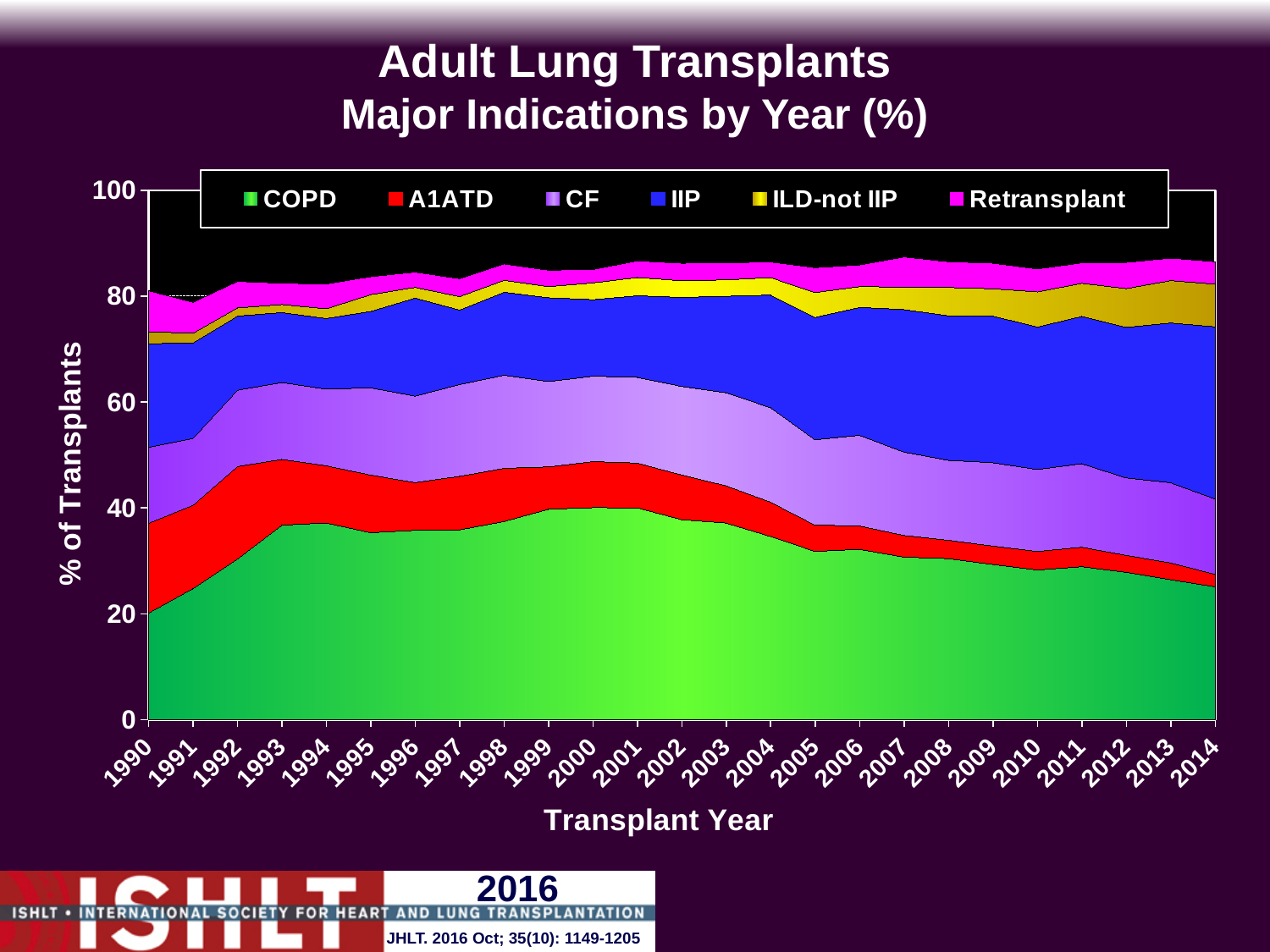
Which indication is shown in green in the legend? COPD Is the COPD value for 2014 greater or less than 20? greater Does the COPD share rise or fall from 2001 to 2014? fall Is the combined total of all six indications in 2007 greater or less than 80? greater Does the COPD share rise or fall from 1990 to 1993? rise What kind of chart is shown on the slide? stacked area chart How many transplant years are shown along the x axis? 25 Is the COPD value for 2014 greater or less than 40? less What is the first year shown on the x axis? 1990 What is the last year shown on the x axis? 2014 How many series does the legend list? 6 What is the label of the y axis? % of Transplants